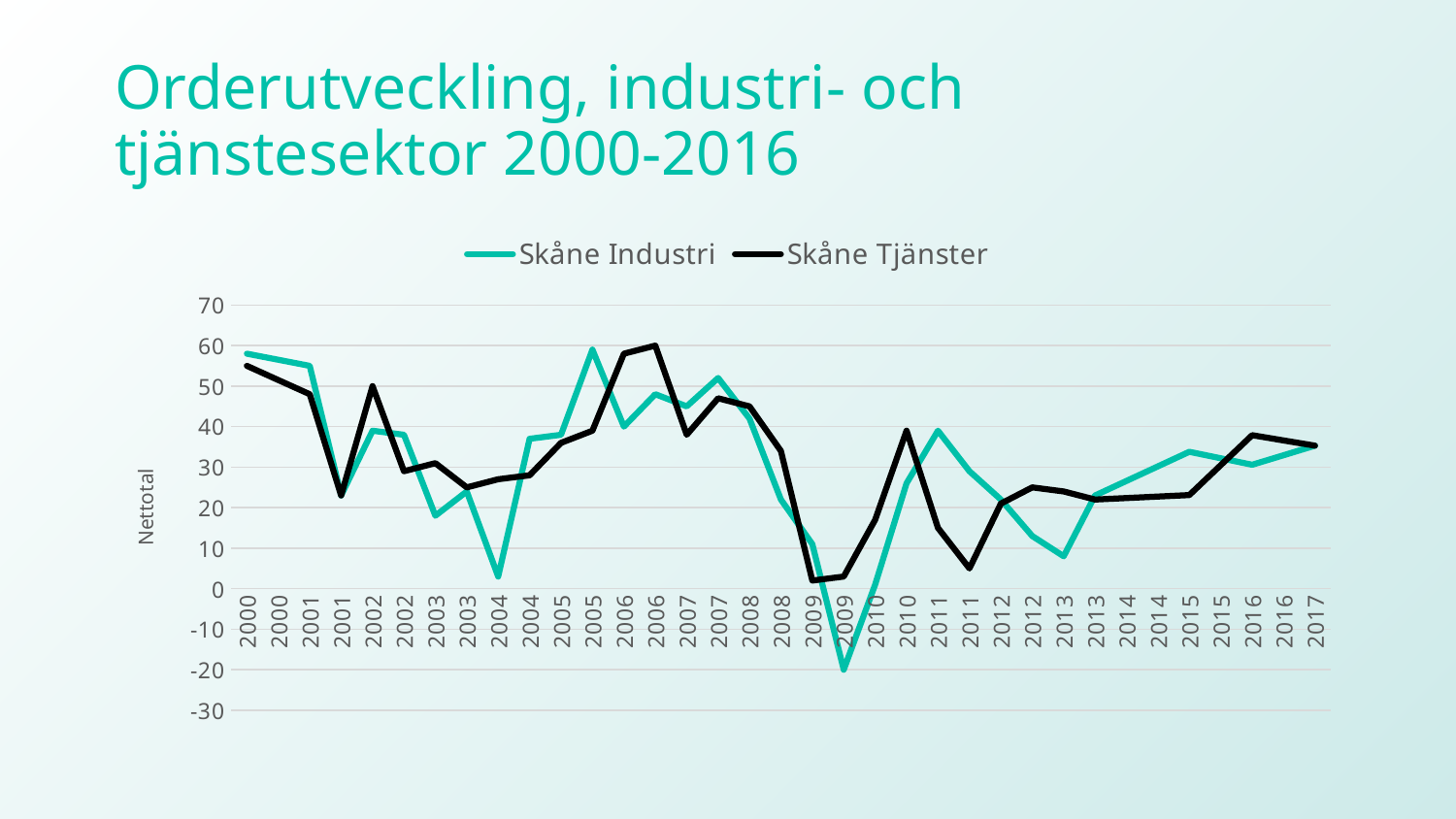
Is the value for Skåne Industri at the second 2009 point greater or less than -10? less What kind of chart is shown on the slide? Line chart Is the value for Skåne Industri at the first 2004 point greater or less than 10? less How many series does the legend list? 2 What are the names of the two series in the legend? Skåne Industri and Skåne Tjänster How many points are labelled along the x axis? 35 Is the value for Skåne Industri at the first 2000 point greater or less than 50? greater What is the label on the vertical axis? Nettotal Does the Skåne Tjänster line rise or fall from the first 2013 point to the first 2016 point? rise At the first 2011 point, which series has the higher value, Skåne Industri or Skåne Tjänster? Skåne Industri At which x-axis point does Skåne Industri reach its lowest value? 2009 (second point)